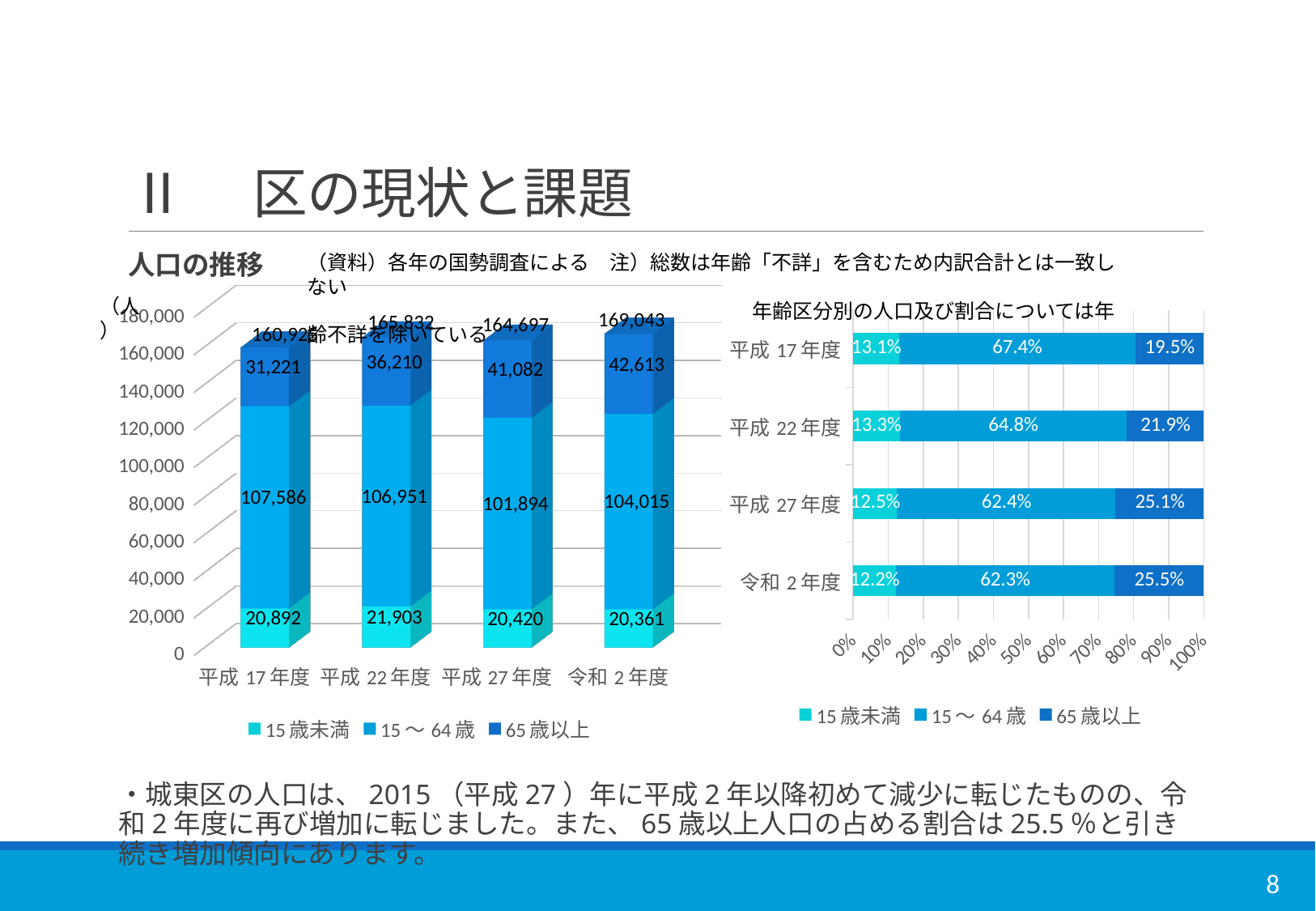
In the left chart (人口の推移), which year has the highest value for 65歳以上? 令和2年度 In the right chart, what is the share of 15～64歳 in 平成17年度? 67.4% In the left chart (人口の推移), does the 65歳以上 value rise or fall from 平成17年度 to 令和2年度? rise What kind of chart is the right chart? stacked bar chart In the left chart (人口の推移), what is the value for 15歳未満 in 平成22年度? 21,903 In the left chart (人口の推移), what is the value for 65歳以上 in 平成27年度? 41,082 In the left chart (人口の推移), what is the value for 15～64歳 in 令和2年度? 104,015 In the left chart (人口の推移), how many series does the legend list? 3 In the right chart, which year has the lowest share of 15歳未満? 令和2年度 In the right chart, what is the share of 65歳以上 in 令和2年度? 25.5% In the left chart (人口の推移), what total population is printed above the bar for 令和2年度? 169,043 In the left chart (人口の推移), what is the difference between the 65歳以上 values for 令和2年度 and 平成17年度? 11,392